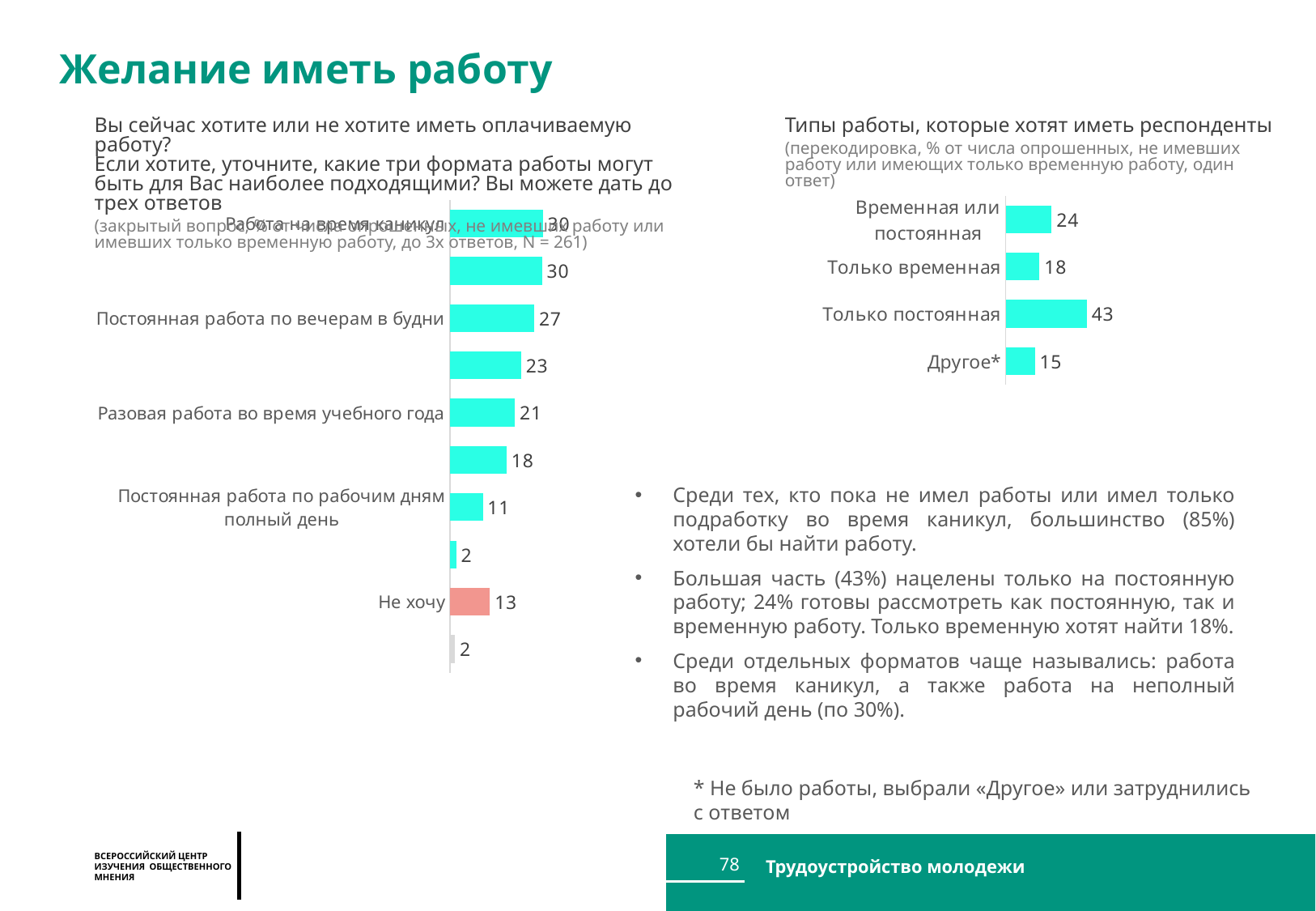
In the right chart 'Типы работы, которые хотят иметь респонденты', what is the value for 'Временная или постоянная'? 24 In the right chart 'Типы работы, которые хотят иметь респонденты', which category has the lowest value? Другое* In the left chart, what is the value for 'Постоянная работа по рабочим дням полный день'? 11 In the right chart 'Типы работы, которые хотят иметь респонденты', what is the value for 'Только постоянная'? 43 In the right chart 'Типы работы, которые хотят иметь респонденты', what is the difference between 'Только постоянная' and 'Только временная'? 25 In the right chart 'Типы работы, которые хотят иметь респонденты', which category has the highest value? Только постоянная In the left chart, which is larger: 'Разовая работа во время учебного года' or 'Не хочу'? Разовая работа во время учебного года In the left chart, what is the value for 'Не хочу'? 13 In the left chart, what is the value for 'Постоянная работа по вечерам в будни'? 27 In the left chart, what colour is the bar for 'Не хочу'? Red (pink) In the right chart 'Типы работы, которые хотят иметь респонденты', how many categories are shown? 4 What type of chart is the right chart 'Типы работы, которые хотят иметь респонденты'? Bar chart